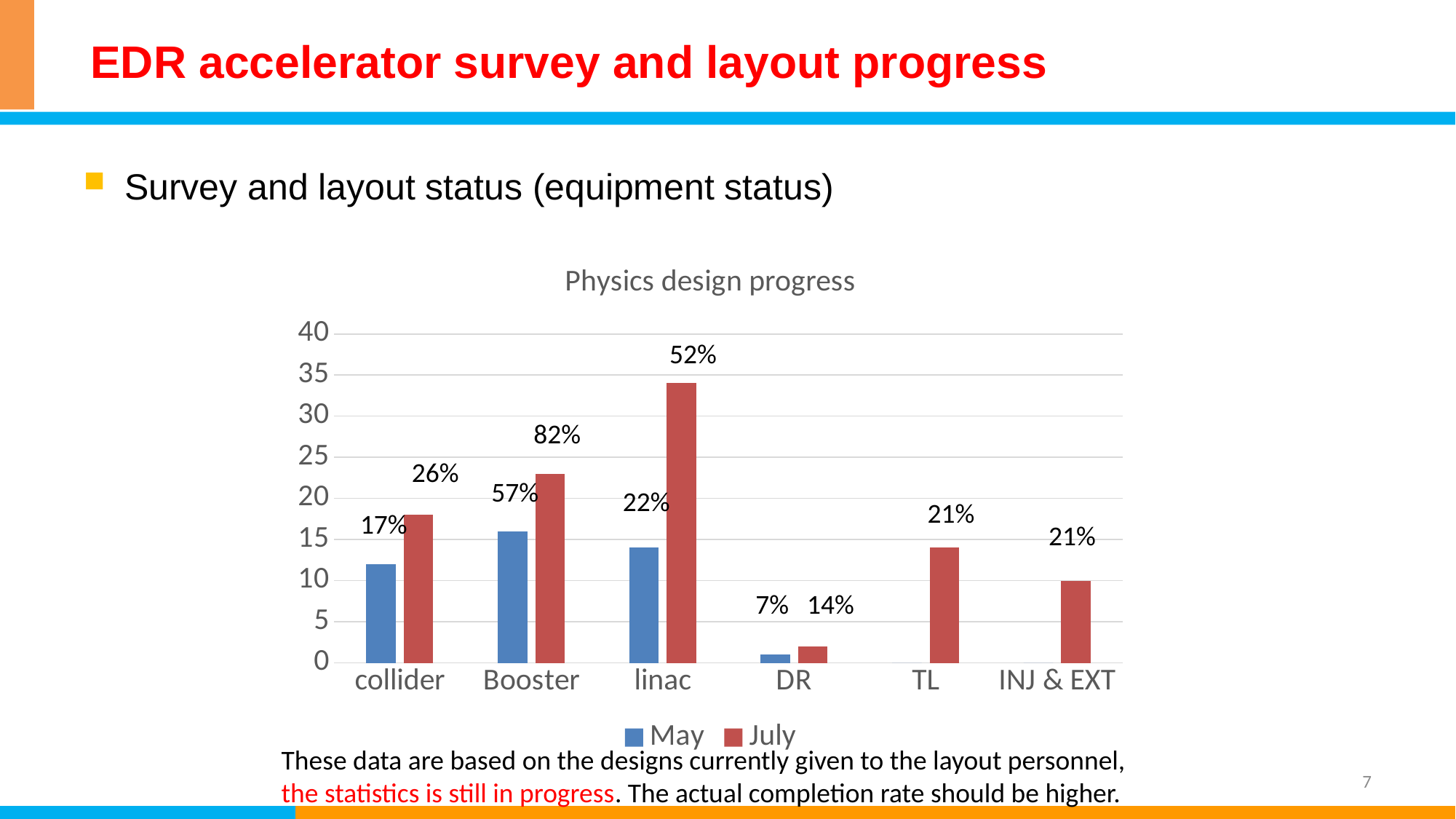
Which category has the tallest May bar? Booster How many series does the legend list? 2 Which category has the tallest July bar? linac Is the July bar for linac greater or less than 30? greater How many categories are shown on the x axis? 6 Is the July bar for DR greater or less than 5? less What data label is shown on the July bar for Booster? 82% What data label is shown on the May bar for linac? 22% What is the title of the chart? Physics design progress What kind of chart is shown on the slide? bar chart What data label is shown on the July bar for DR? 14% Which is taller, the July bar for TL or the July bar for INJ & EXT? TL